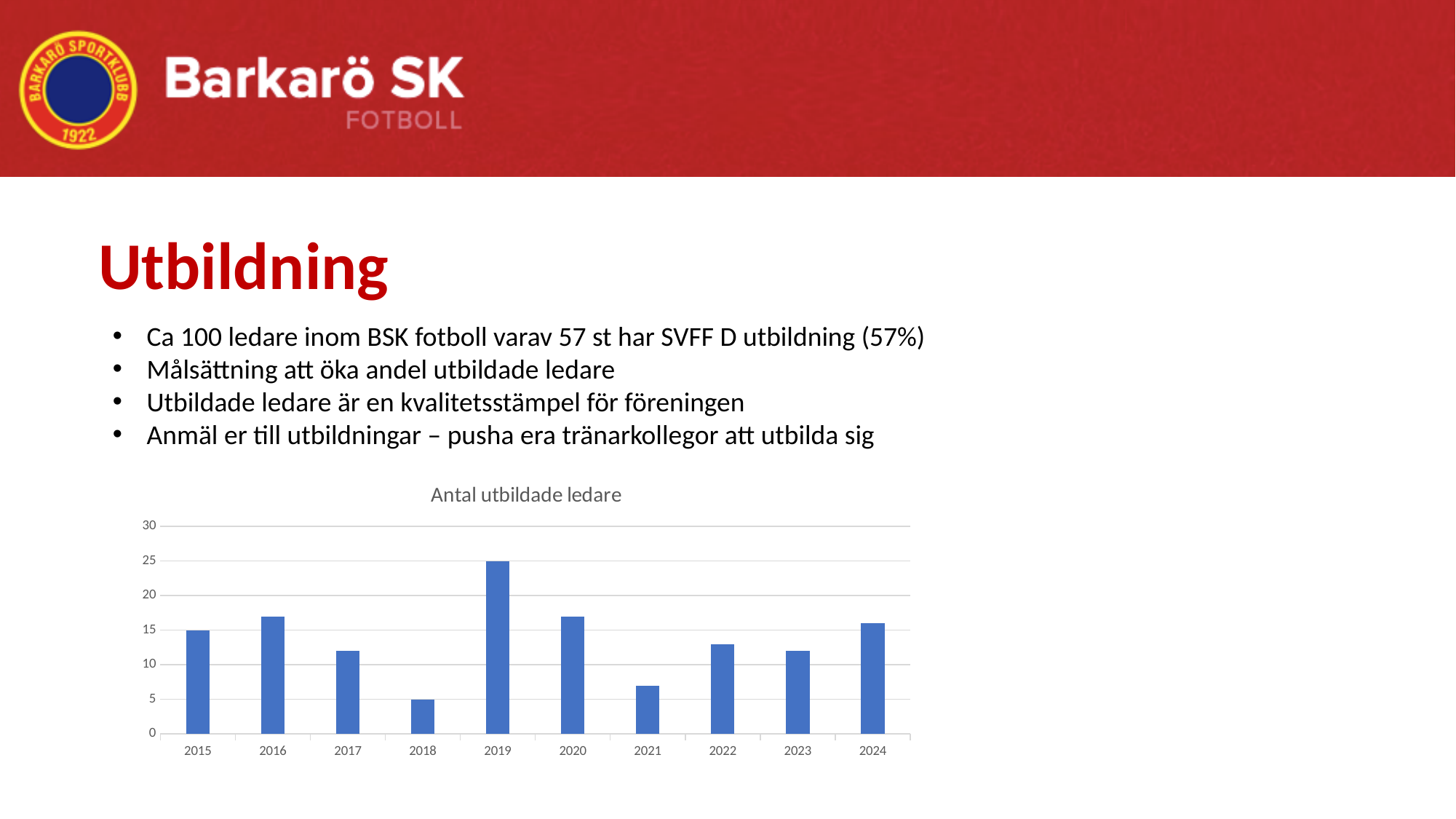
Is the value for 2021 greater or less than 10? less How many years are shown on the x axis of the chart? 10 What is the value for 2018? 5 What is the value for 2019? 25 What is the title of the chart? Antal utbildade ledare Which is larger, the value for 2020 or the value for 2023? 2020 What type of chart is shown on the slide? bar chart Is the value for 2016 greater or less than 15? greater Which year has the highest value in the chart? 2019 Is the value for 2024 greater or less than 20? less What is the value for 2015? 15 Which year has the lowest value in the chart? 2018